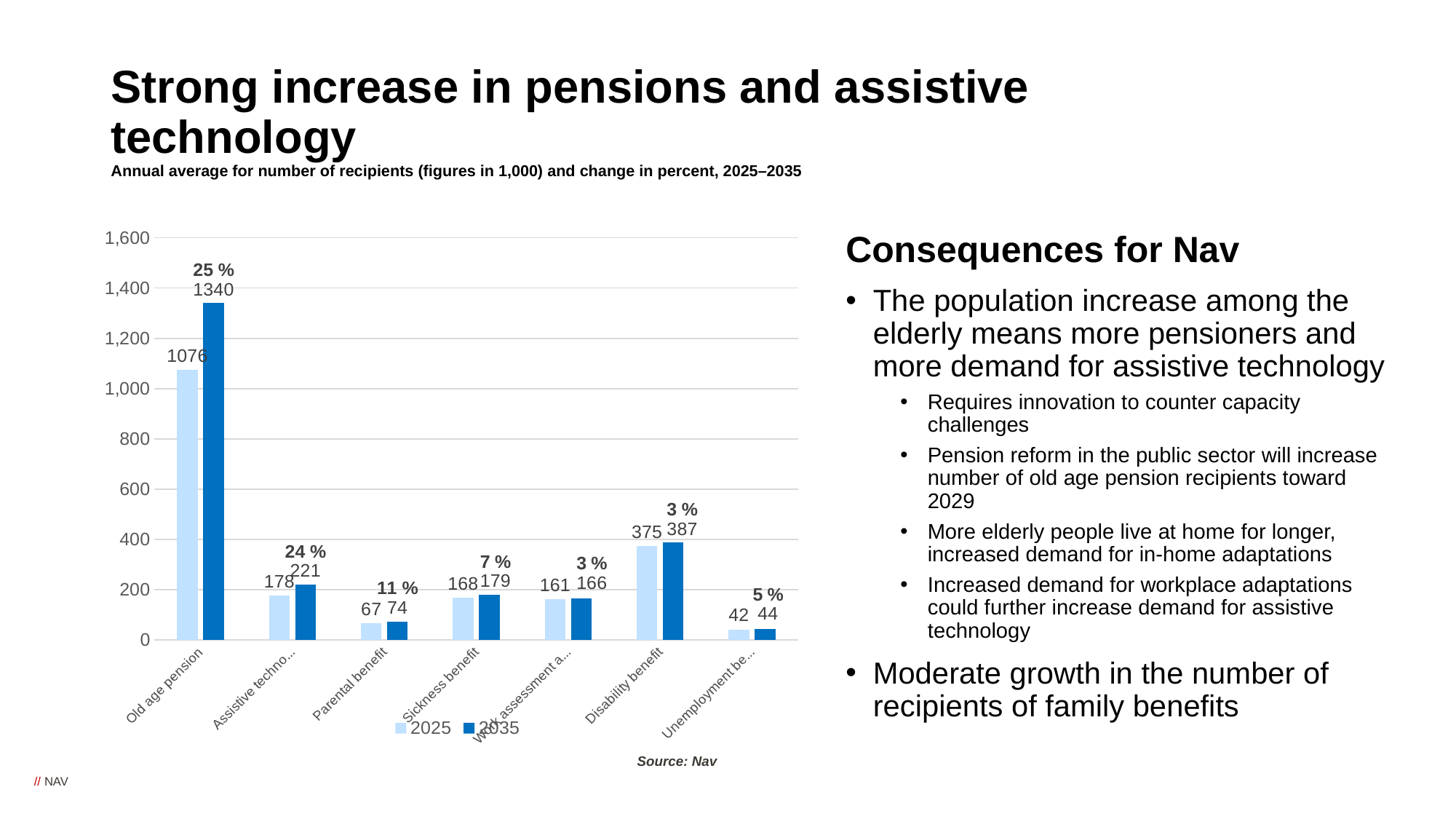
Which category has the lowest 2025 value? Unemployment benefit What percentage change is shown above the Sickness benefit bars? 7 % What is the 2025 value for Disability benefit? 375 Which category has the highest 2035 value? Old age pension What is the 2035 value for Old age pension? 1340 What is the difference between the 2035 and 2025 values for Old age pension? 264 Is the 2025 value for Old age pension greater or less than 1,000? greater What is the 2025 value for Parental benefit? 67 What kind of chart is shown on the slide? Bar chart Which is larger, the 2035 value for Sickness benefit or the 2035 value for Disability benefit? Disability benefit How many categories are shown on the x axis? 7 How many series does the legend list? 2